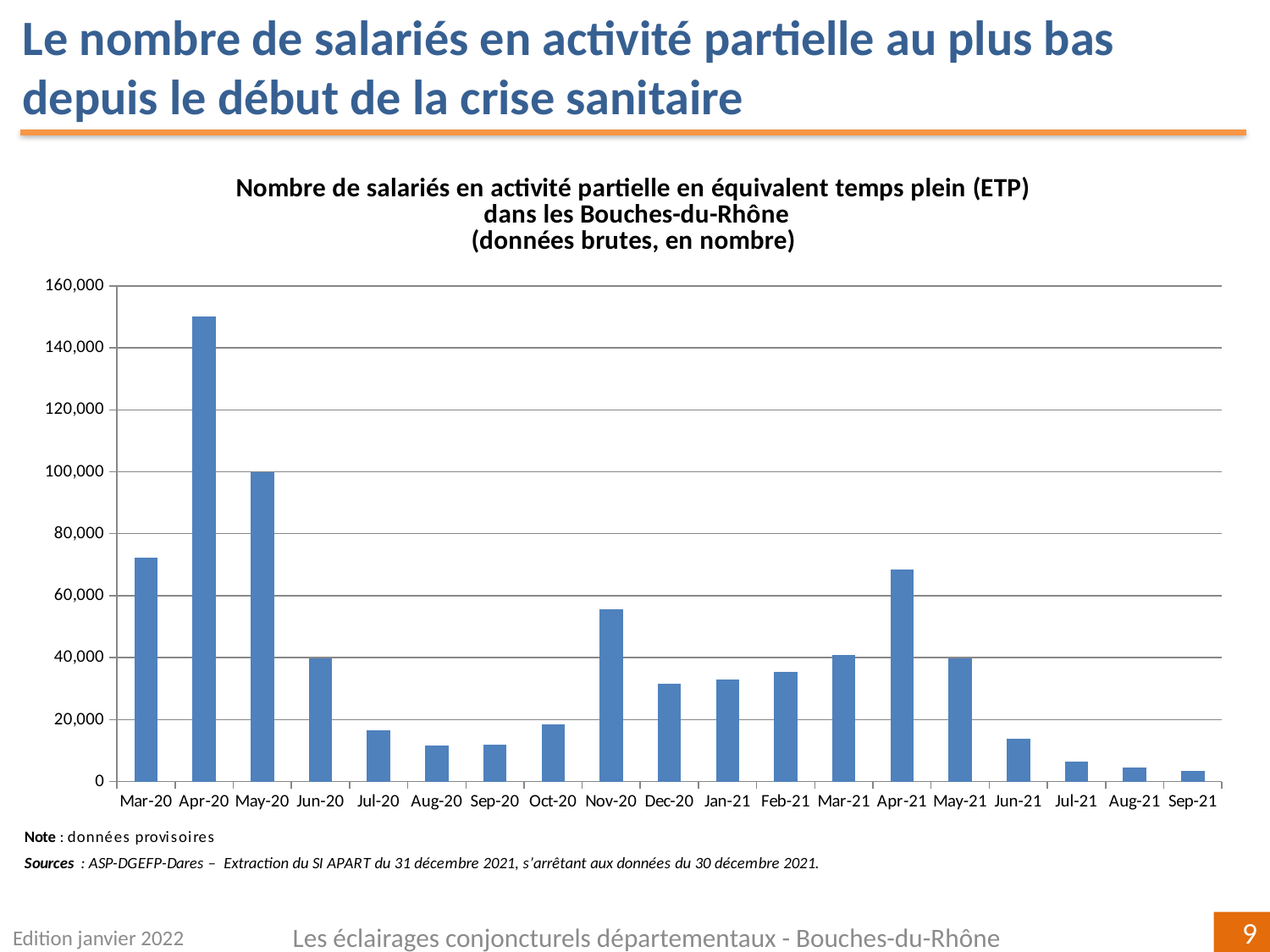
How many months are plotted on the x axis? 19 Which month has the highest number of salariés en activité partielle? Apr-20 Do the values rise or fall from Apr-20 to Aug-20? fall Is the value for Apr-20 greater or less than 140,000? greater Which is larger, the value for Nov-20 or the value for Dec-20? Nov-20 Is the value for Jul-20 greater or less than 20,000? less Which month has the lowest number of salariés en activité partielle? Sep-21 What is the title of the chart? Nombre de salariés en activité partielle en équivalent temps plein (ETP) dans les Bouches-du-Rhône (données brutes, en nombre) Which is larger, the value for Apr-21 or the value for Mar-21? Apr-21 What kind of chart is shown on the slide? bar chart Is the value for Apr-21 greater or less than 60,000? greater